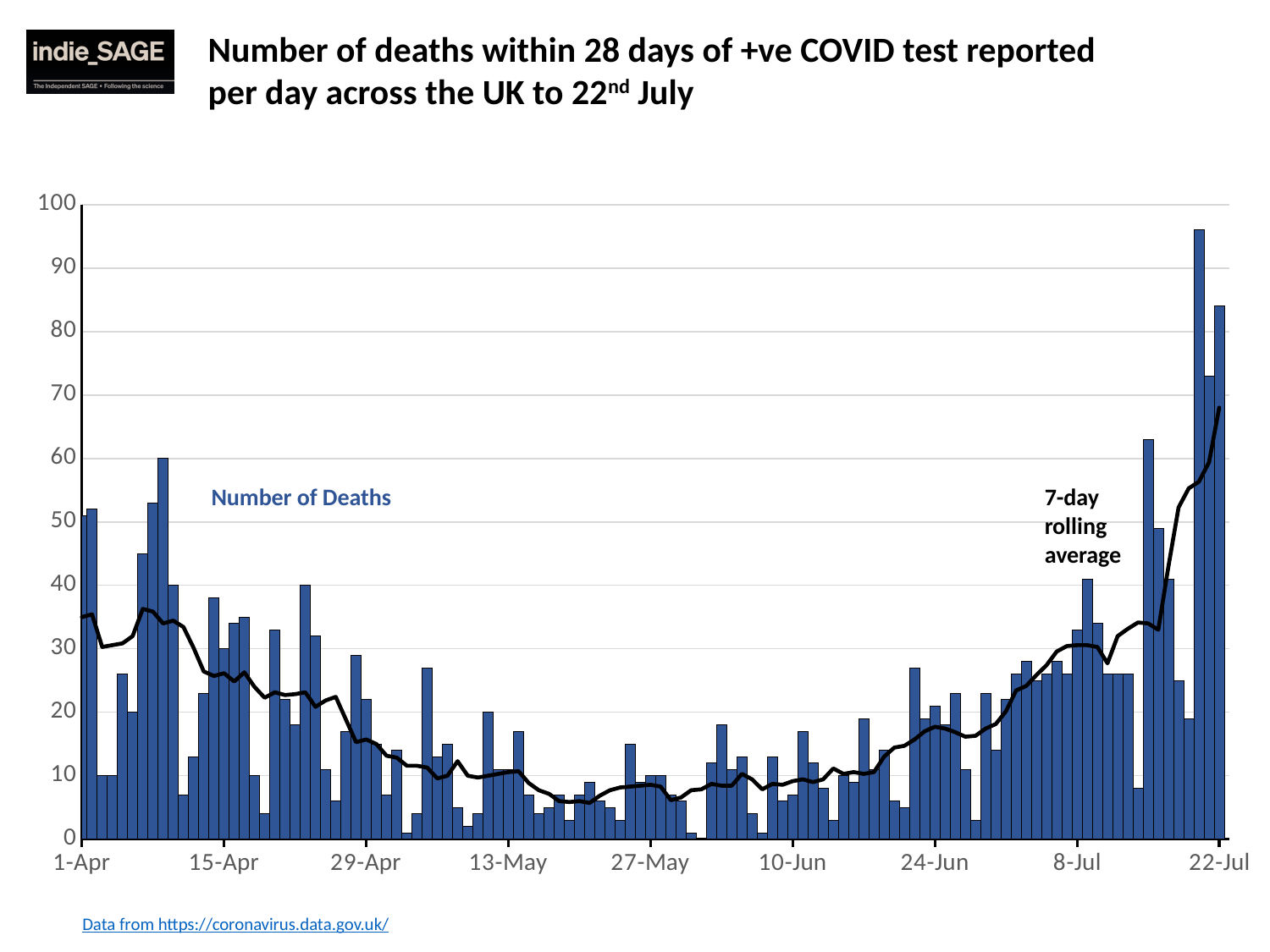
How many data series are plotted on the chart? 2 Do the daily deaths generally rise or fall between 1-Apr and 27-May? fall Is the number of deaths on 13-May greater or less than 20? less Is the highest daily number of deaths on the chart greater or less than 90? greater Do the daily deaths generally rise or fall between 24-Jun and 22-Jul? rise Is the number of deaths on 8-Jul greater or less than 20? greater What kind of chart is used to show the daily number of deaths? bar chart What do the blue bars on the chart represent? Number of Deaths What does the black line on the chart represent? 7-day rolling average